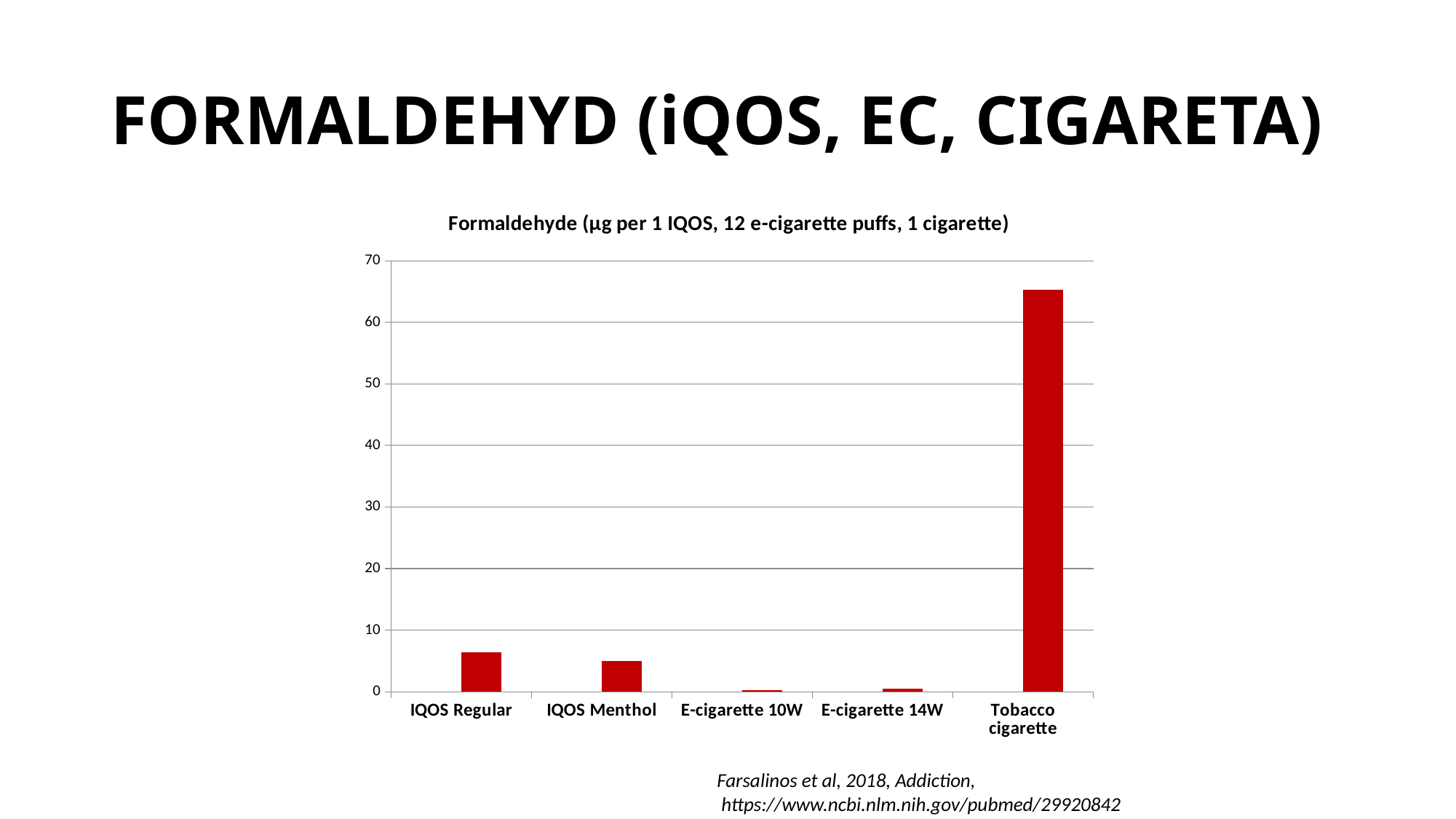
Which is larger, the value for IQOS Regular or the value for Tobacco cigarette? Tobacco cigarette Which category has the highest formaldehyde value? Tobacco cigarette How many categories are shown on the x axis of the chart? 5 What kind of chart is shown on the slide? bar chart Is the value for E-cigarette 14W greater or less than 10? less Is the value for Tobacco cigarette greater or less than 70? less What colour are the bars in the chart? red Is the value for Tobacco cigarette greater or less than 60? greater What is the title of the chart? Formaldehyde (µg per 1 IQOS, 12 e-cigarette puffs, 1 cigarette) Which is larger, the value for IQOS Regular or the value for IQOS Menthol? IQOS Regular